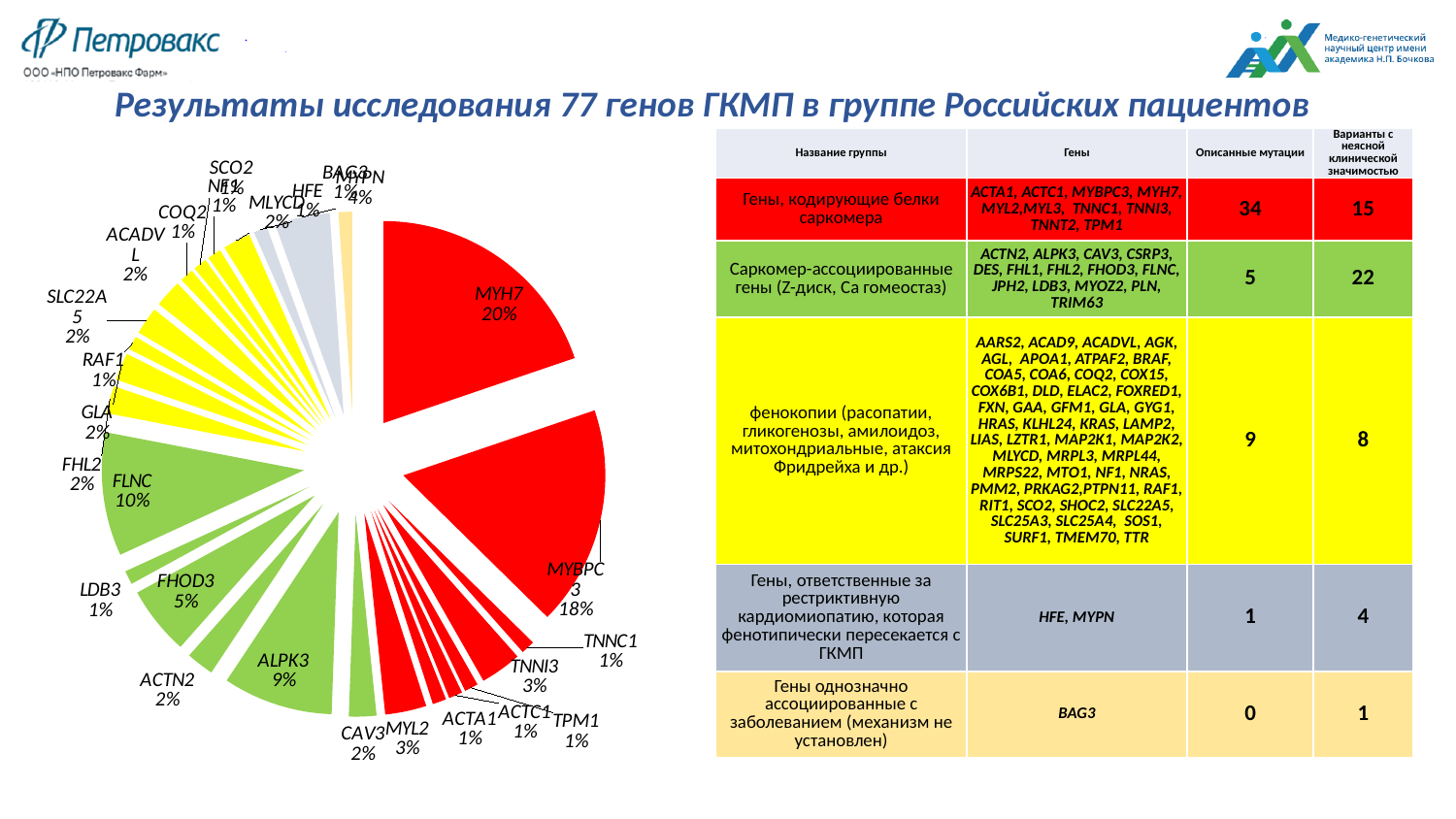
Which gene has the largest slice in the pie chart? MYH7 What percentage is shown for FLNC in the pie chart? 10% What percentage is shown for FHOD3 in the pie chart? 5% By how many percentage points does the FLNC slice exceed the ALPK3 slice? 1 What kind of chart is shown on the left of the slide? pie chart What share of the pie chart does MYBPC3 account for? 18% What percentage is shown for TNNI3 in the pie chart? 3% By how many percentage points does the MYH7 slice exceed the MYBPC3 slice? 2 Which slice is larger in the pie chart, FLNC or FHOD3? FLNC What share of the pie chart does MYH7 account for? 20% Which slice is larger in the pie chart, MYH7 or MYBPC3? MYH7 What percentage is shown for ALPK3 in the pie chart? 9%